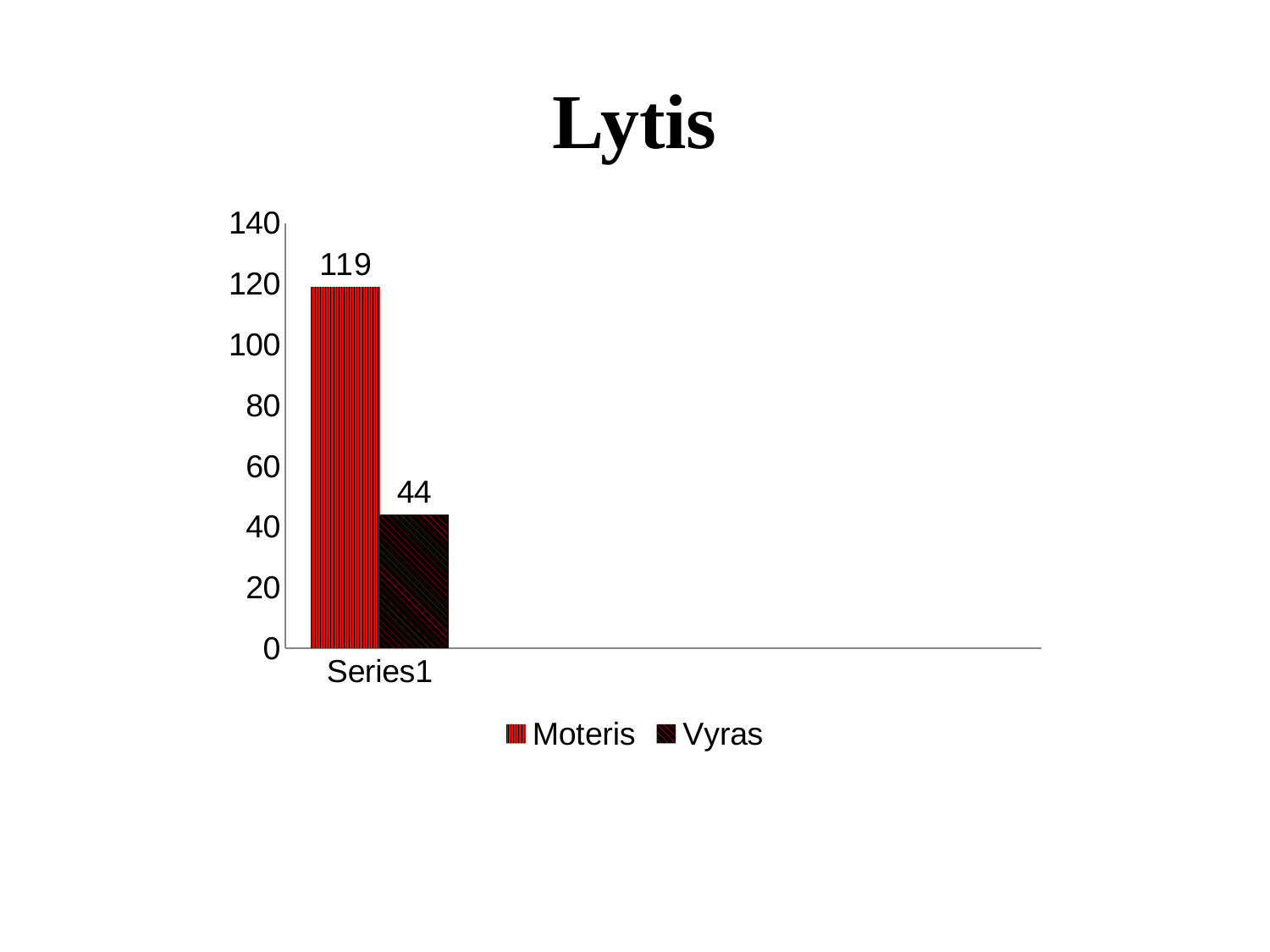
What is the difference between the values for Moteris and Vyras? 75 What kind of chart is shown on the slide? bar chart Which is larger, the value for Moteris or the value for Vyras? Moteris Which series has the lowest value? Vyras How many series does the legend list? 2 Is the value for Moteris greater or less than 100? greater Which series has the highest value? Moteris What is the title of the slide? Lytis Is the value for Vyras greater or less than 60? less What is the value for Vyras? 44 What is the category label shown on the x axis? Series1 What is the value for Moteris? 119